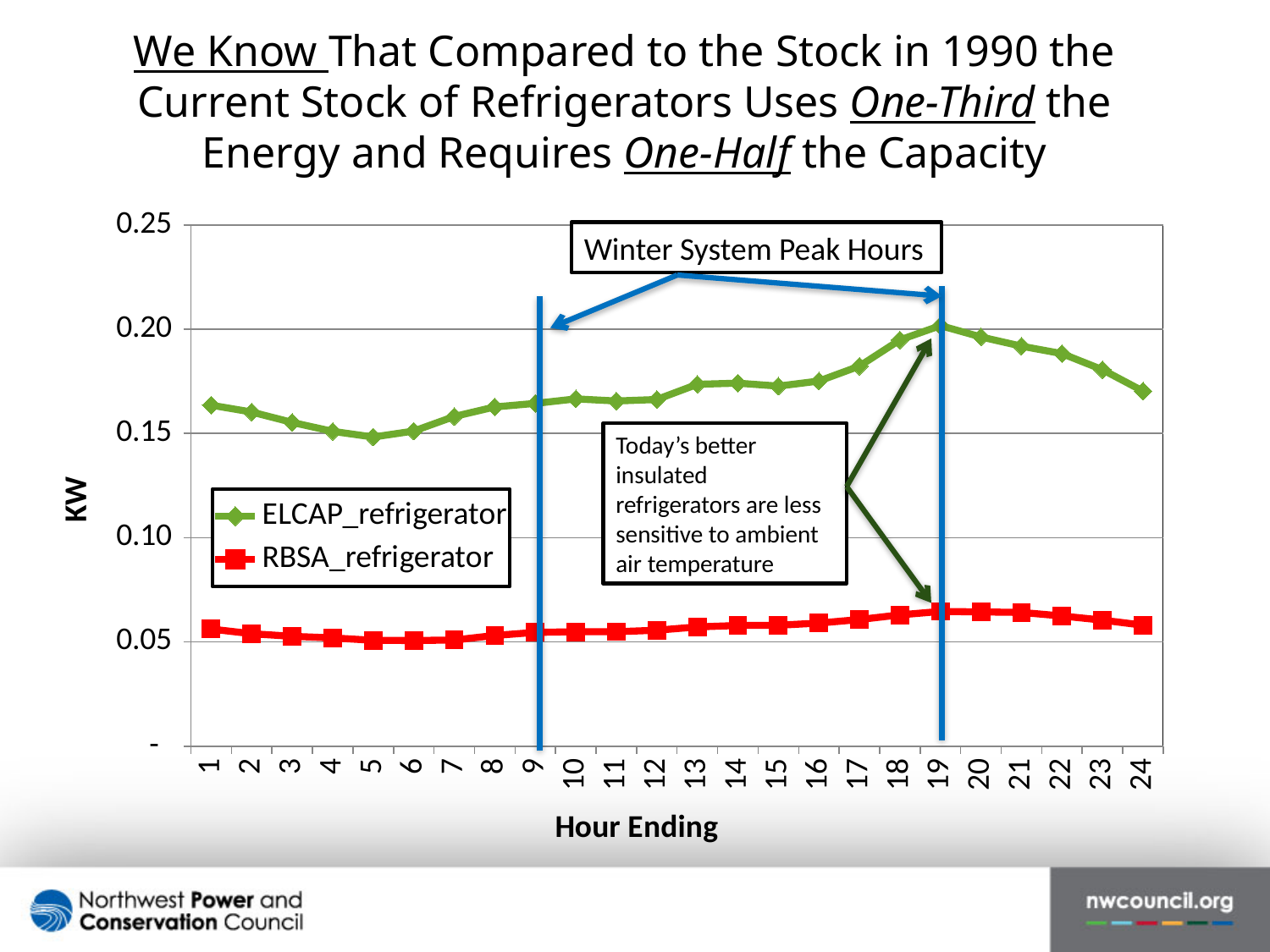
Is the ELCAP_refrigerator value at hour ending 1 greater or less than 0.15? greater What is the label on the y axis? KW Is the ELCAP_refrigerator value at hour ending 19 greater or less than 0.15? greater What kind of chart is shown on the slide? line chart At hour ending 19, which series has the larger value, ELCAP_refrigerator or RBSA_refrigerator? ELCAP_refrigerator Does the ELCAP_refrigerator series rise or fall from hour ending 5 to hour ending 19? rise What does the boxed annotation at the top of the chart say? Winter System Peak Hours Is the RBSA_refrigerator value at hour ending 5 greater or less than 0.10? less How many series does the legend list? 2 Which series has the higher values across all hours, ELCAP_refrigerator or RBSA_refrigerator? ELCAP_refrigerator How many hours are plotted along the x axis? 24 Does the ELCAP_refrigerator series rise or fall from hour ending 19 to hour ending 24? fall